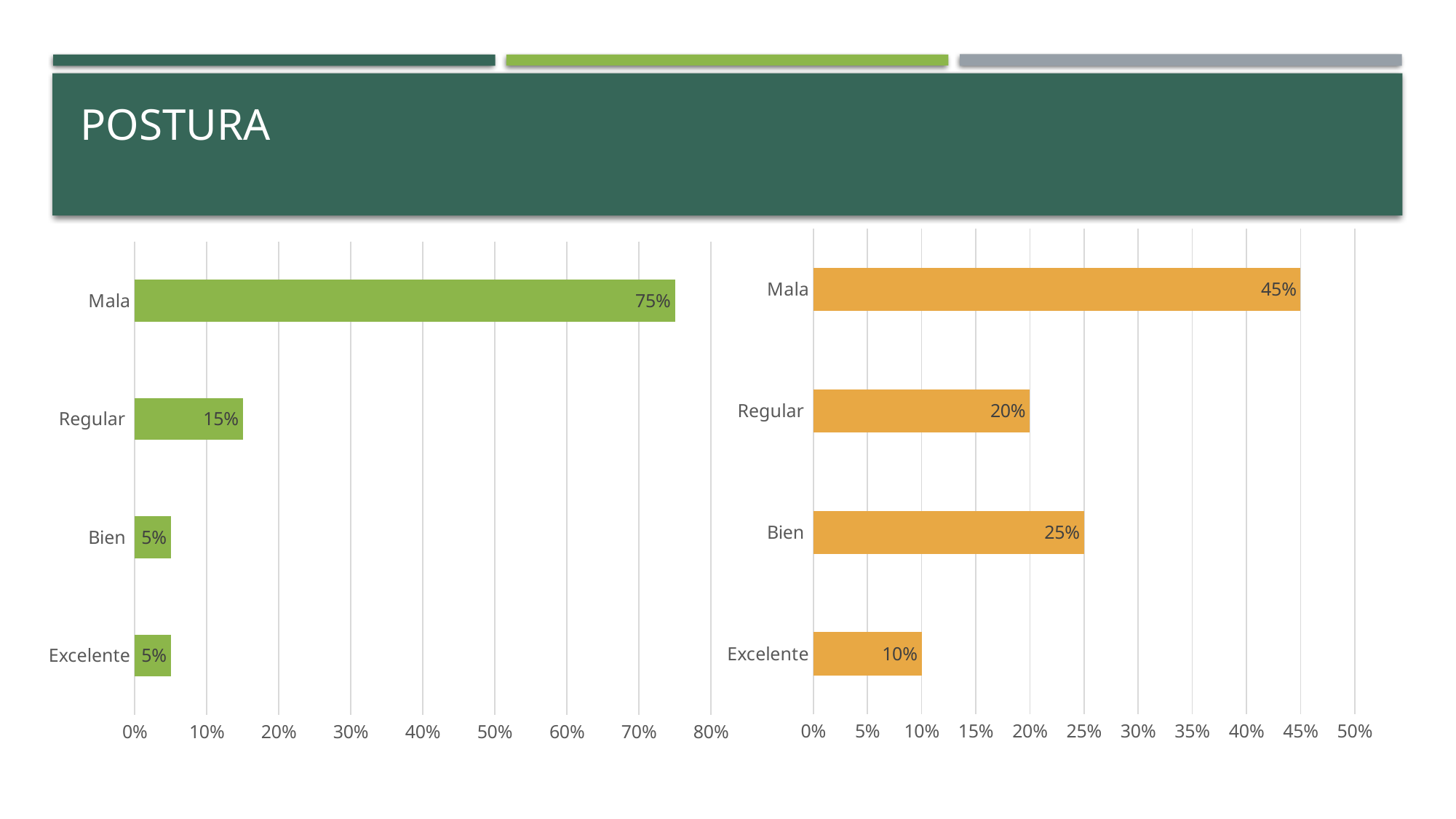
In the left chart, which category has the highest value? Mala In the left chart, what is the difference between the values for Mala and Regular? 60% In the right chart, what is the value for Excelente? 10% In the left chart, how many categories are shown? 4 In the left chart, what is the value for Mala? 75% In the right chart, which is larger, the value for Regular or the value for Bien? Bien In the left chart, what is the value for Regular? 15% In the right chart, what is the value for Bien? 25% In the right chart, which category has the lowest value? Excelente What is the title of the slide? POSTURA What kind of chart is the right chart? bar chart In the right chart, what is the difference between the values for Mala and Bien? 20%